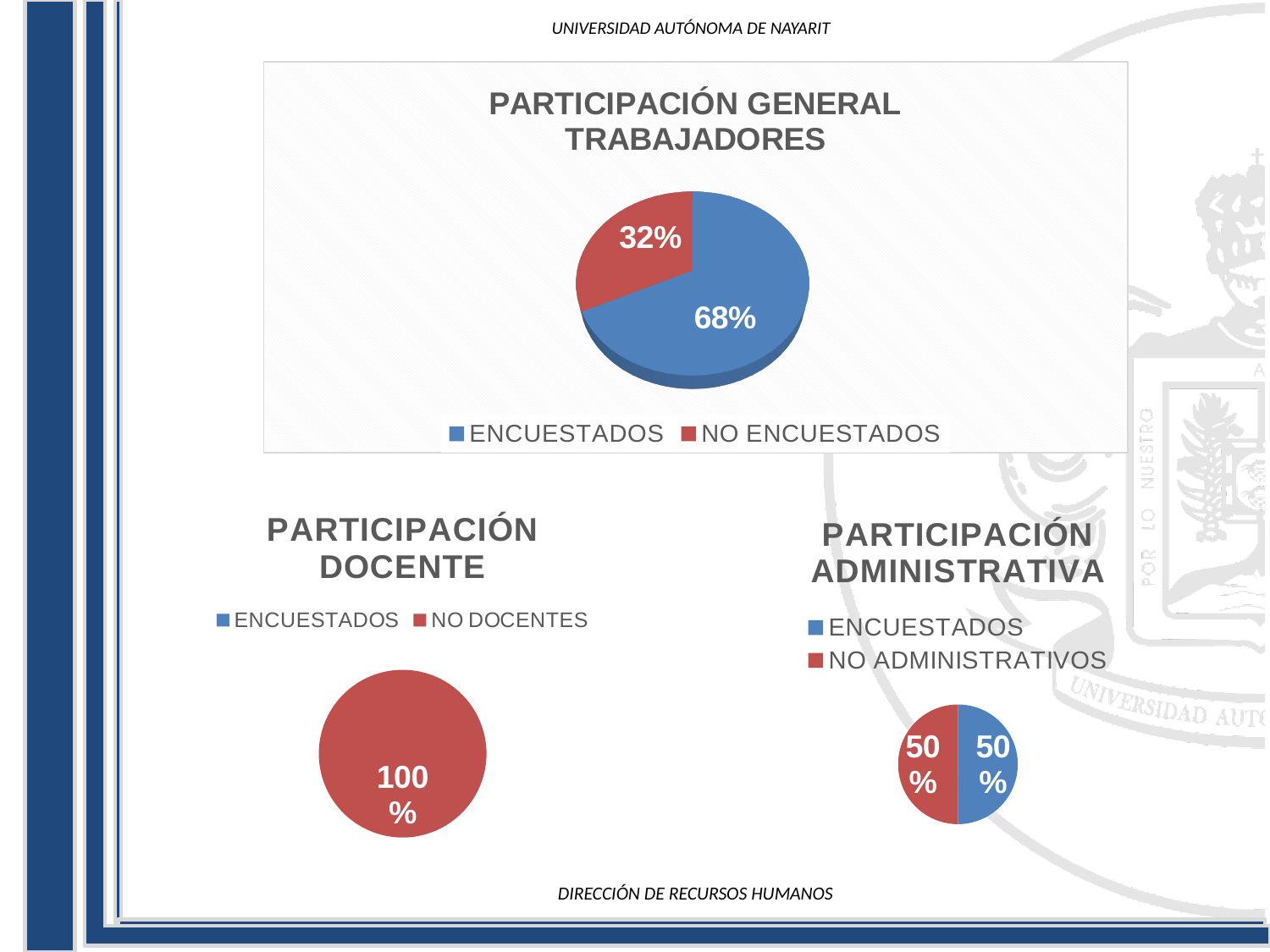
In the 'PARTICIPACIÓN GENERAL TRABAJADORES' chart, what share of the pie is ENCUESTADOS? 68% How many entries does the legend of the 'PARTICIPACIÓN GENERAL TRABAJADORES' chart list? 2 How many pie charts are shown on the slide? 3 In the 'PARTICIPACIÓN ADMINISTRATIVA' chart, what share of the pie is NO ADMINISTRATIVOS? 50% In the 'PARTICIPACIÓN ADMINISTRATIVA' chart, what share of the pie is ENCUESTADOS? 50% In the 'PARTICIPACIÓN GENERAL TRABAJADORES' chart, which is larger, ENCUESTADOS or NO ENCUESTADOS? ENCUESTADOS In the 'PARTICIPACIÓN GENERAL TRABAJADORES' chart, what is the difference between the ENCUESTADOS and NO ENCUESTADOS shares? 36% In the 'PARTICIPACIÓN GENERAL TRABAJADORES' chart, which slice is the largest? ENCUESTADOS What kind of chart is 'PARTICIPACIÓN GENERAL TRABAJADORES'? Pie chart In the 'PARTICIPACIÓN GENERAL TRABAJADORES' chart, which slice is the smallest? NO ENCUESTADOS